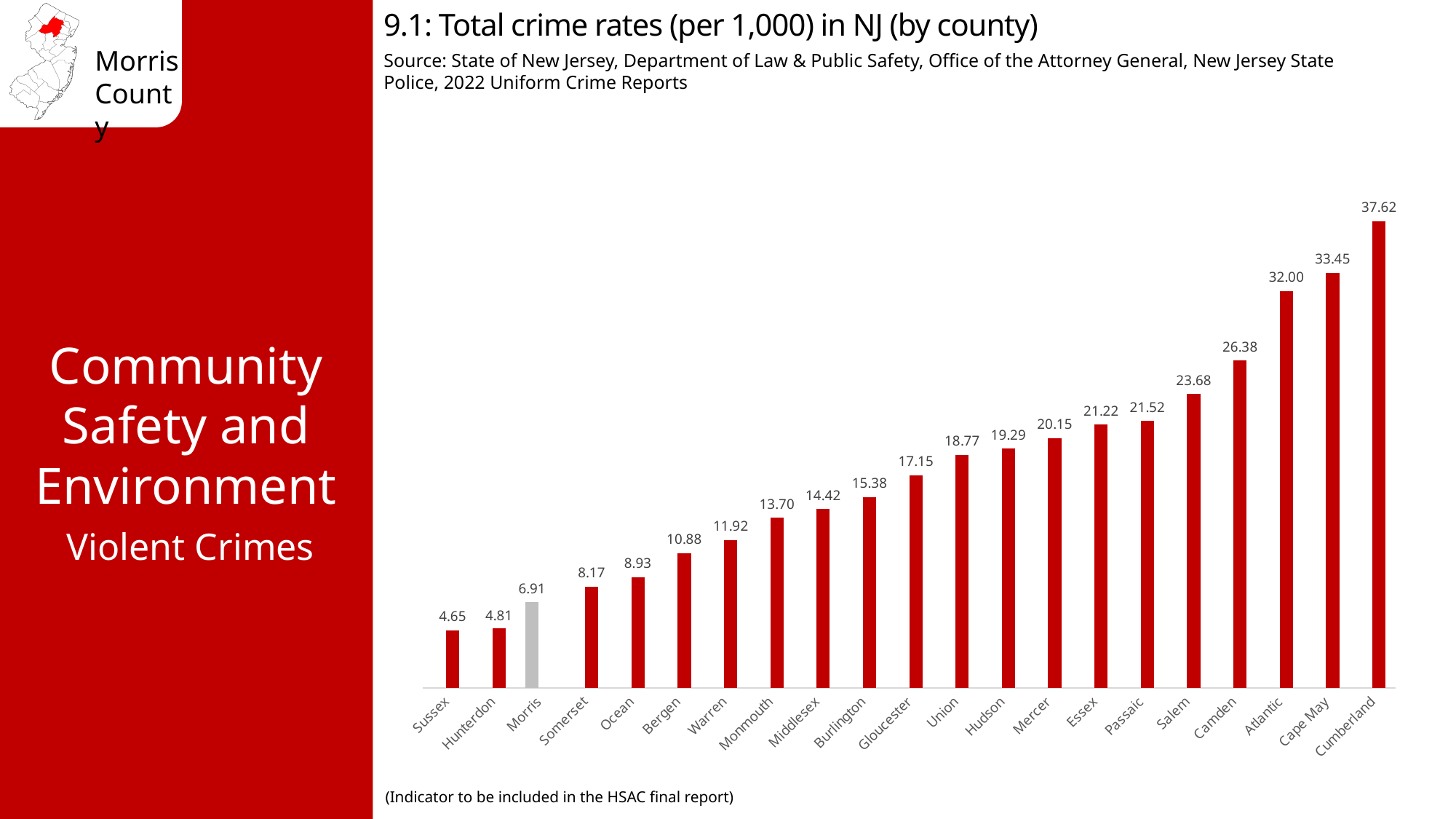
What is the difference between the total crime rates of Morris and Sussex? 2.26 Which county has the lowest total crime rate? Sussex What is the total crime rate (per 1,000) for Essex county? 21.22 What is the total crime rate (per 1,000) for Bergen county? 10.88 What is the total crime rate (per 1,000) for Morris county? 6.91 How many counties are shown in the chart? 21 Which county has a higher total crime rate, Hudson or Somerset? Hudson Which county has the highest total crime rate? Cumberland Which county has a higher total crime rate, Cape May or Atlantic? Cape May What is the difference between the total crime rates of Cumberland and Morris? 30.71 Which county's bar is shown in grey rather than red? Morris What kind of chart is used to show total crime rates by county? Bar chart